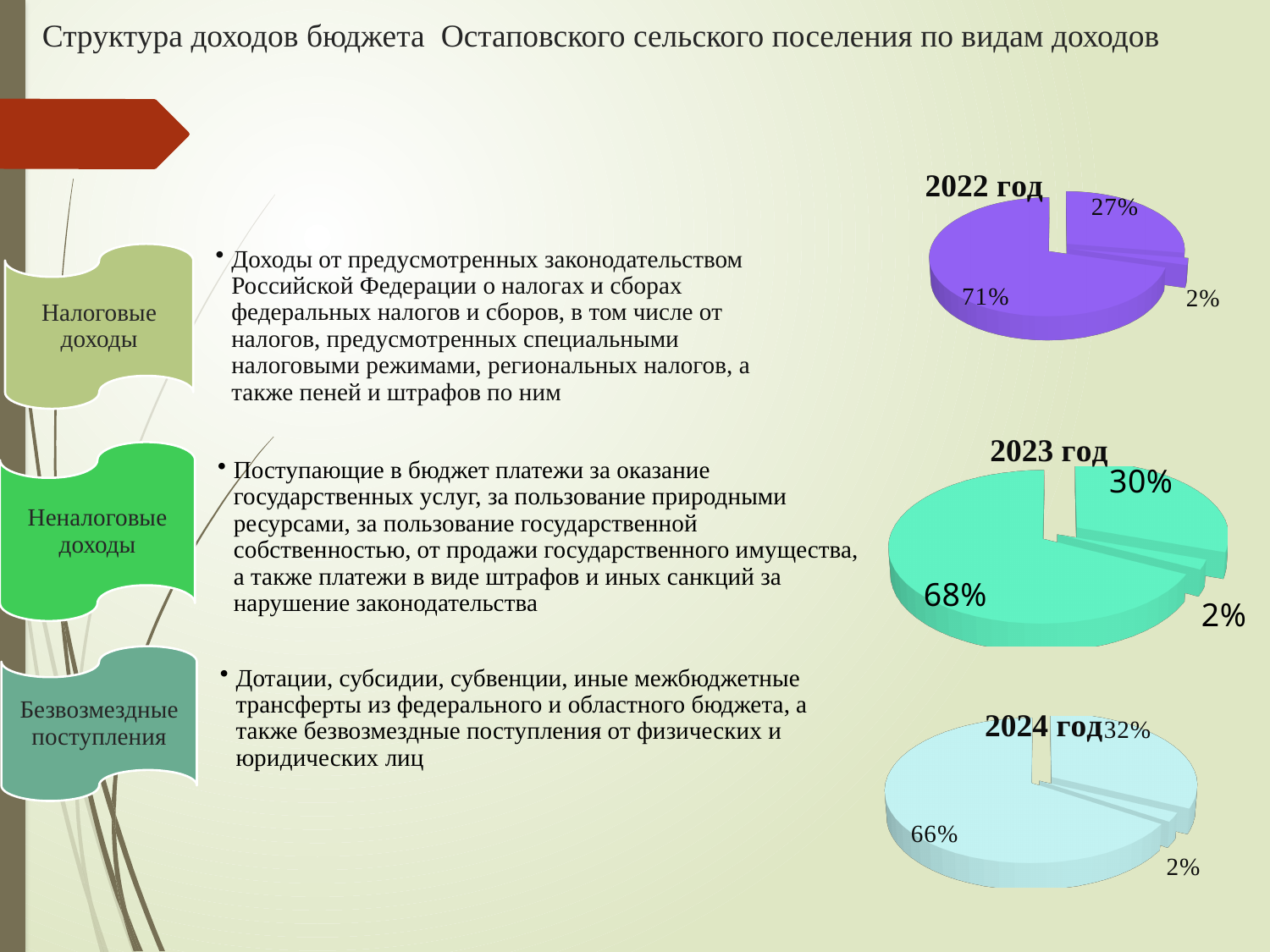
In the "2022 год" pie chart, what is the largest slice's share? 71% How many pie charts are shown on the slide? 3 How many slices does the "2022 год" pie chart have? 3 Which is larger: the largest slice in the "2022 год" chart or the largest slice in the "2024 год" chart? 2022 год In the "2023 год" pie chart, what is the difference between the largest slice and the second-largest slice? 38% In the "2022 год" pie chart, what is the smallest slice's share? 2% How many slices does the "2023 год" pie chart have? 3 In the "2023 год" pie chart, what is the largest slice's share? 68% What type of chart is the "2022 год" chart? pie chart In the "2024 год" pie chart, what is the largest slice's share? 66% In the "2024 год" pie chart, what is the smallest slice's share? 2% In the "2024 год" pie chart, what is the difference between the largest slice and the second-largest slice? 34%